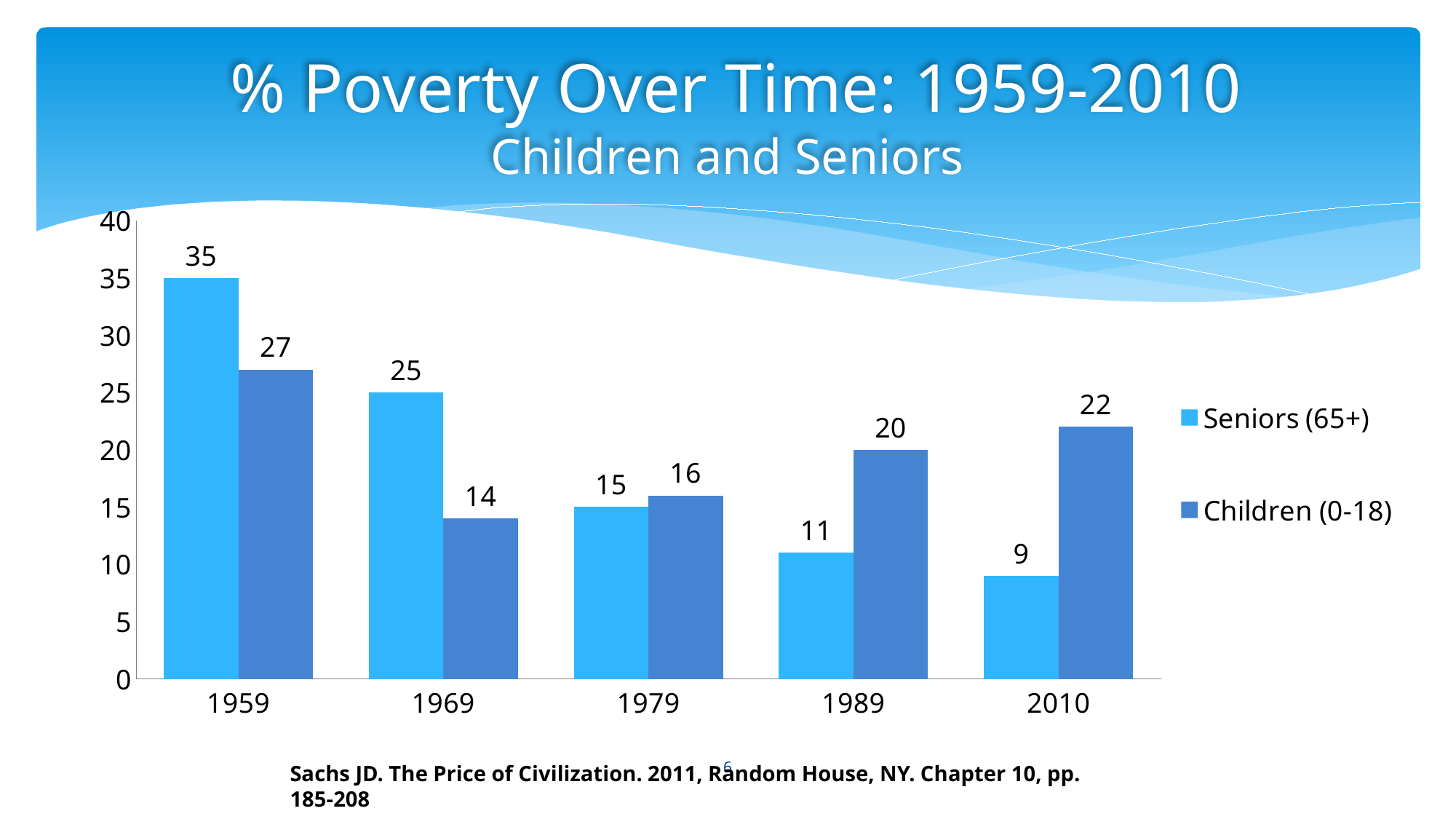
What is the value for Seniors (65+) in 1959? 35 In which year is the Seniors (65+) value highest? 1959 What is the value for Children (0-18) in 1979? 16 How many years are shown on the x axis? 5 What kind of chart is shown on the slide? Bar chart Do the Seniors (65+) values rise or fall from 1959 to 2010? Fall What is the difference between the Seniors (65+) and Children (0-18) values in 1989? 9 What is the title of the chart? % Poverty Over Time: 1959-2010 Children and Seniors In which year is the Children (0-18) value lowest? 1969 What is the value for Children (0-18) in 2010? 22 How many series does the legend list? 2 Which is larger in 1969, the Seniors (65+) value or the Children (0-18) value? Seniors (65+)